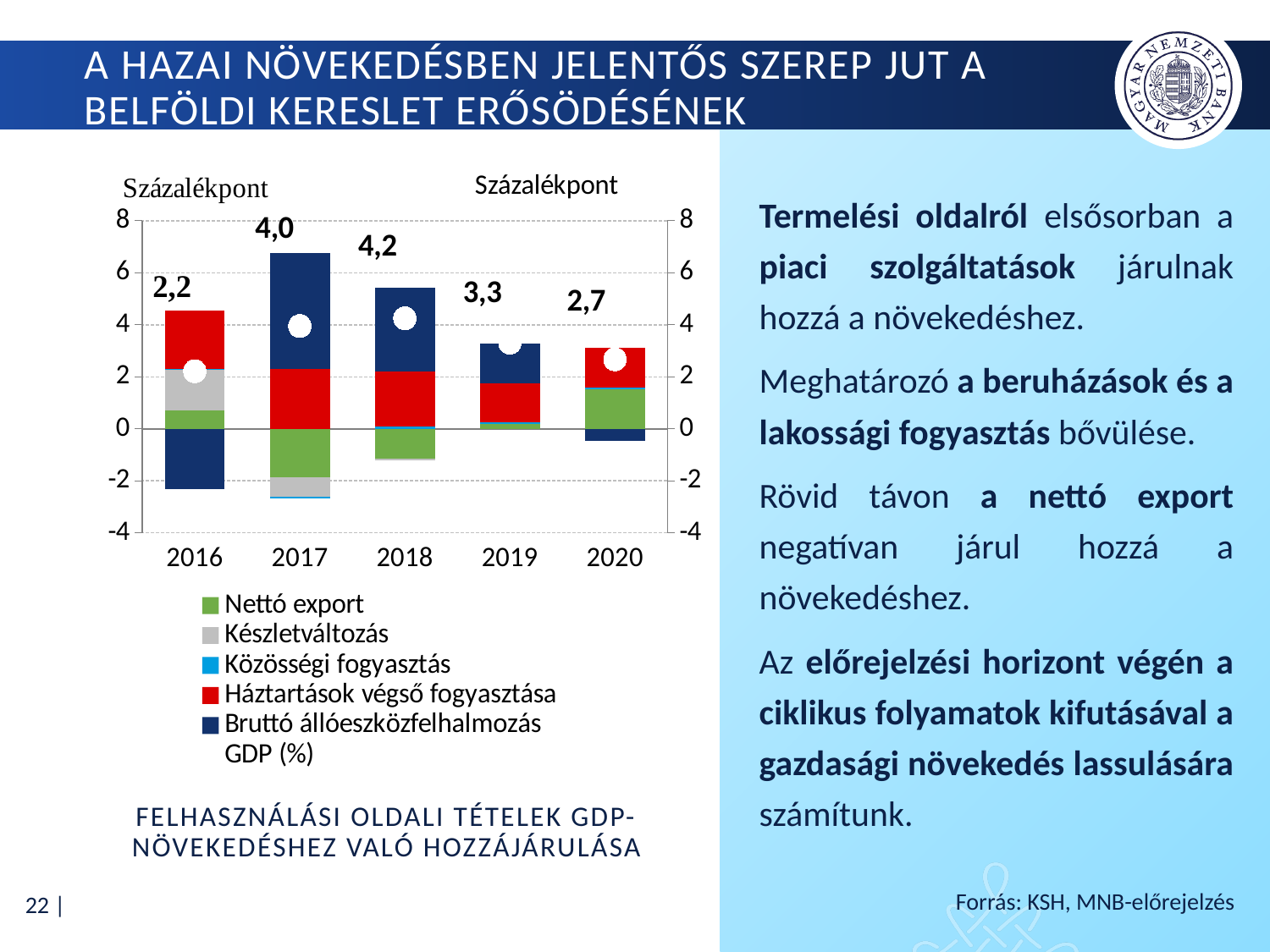
Which year has the larger GDP (%) value, 2017 or 2019? 2017 What is the GDP (%) value shown for 2018? 4,2 What is the GDP (%) value shown for 2020? 2,7 Is the top of the stacked bar for 2017 greater or less than 6? greater How many entries does the legend list? 6 Does the GDP (%) value rise or fall from 2018 to 2020? Fall In which year is the GDP (%) value the highest? 2018 What is the difference between the GDP (%) values for 2018 and 2016? 2,0 What kind of chart is shown on the slide? Stacked bar chart combined with point markers for GDP (%) What is the GDP (%) value shown for 2016? 2,2 In which year is the GDP (%) value the lowest? 2016 How many years are shown on the x axis? 5